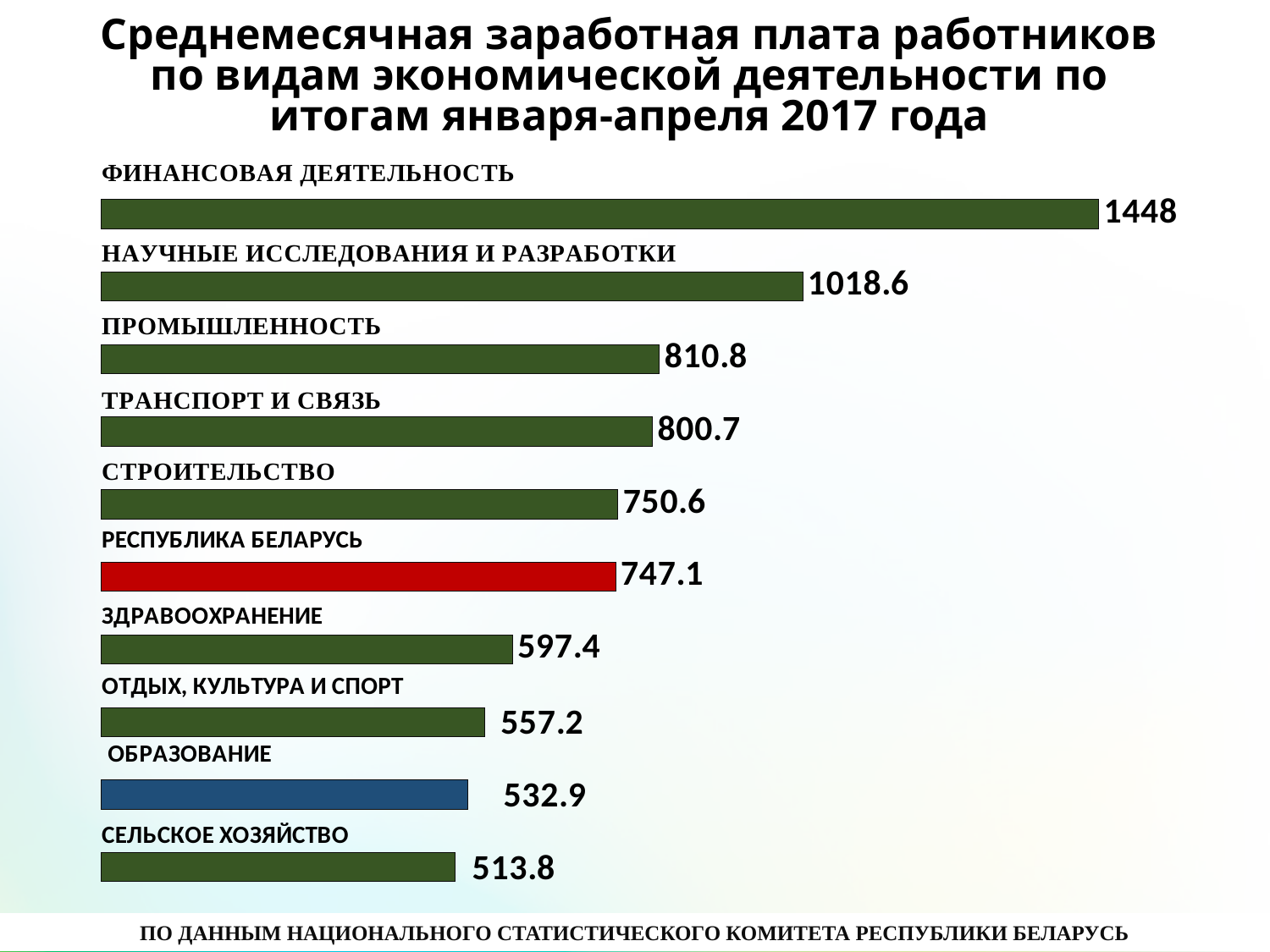
What is the difference between the values for ФИНАНСОВАЯ ДЕЯТЕЛЬНОСТЬ and НАУЧНЫЕ ИССЛЕДОВАНИЯ И РАЗРАБОТКИ? 429.4 Which is larger, the value for ПРОМЫШЛЕННОСТЬ or the value for ТРАНСПОРТ И СВЯЗЬ? ПРОМЫШЛЕННОСТЬ Which category's bar is coloured red? РЕСПУБЛИКА БЕЛАРУСЬ Which category has the lowest value? СЕЛЬСКОЕ ХОЗЯЙСТВО Which category has the highest value? ФИНАНСОВАЯ ДЕЯТЕЛЬНОСТЬ Which is larger, the value for ОТДЫХ, КУЛЬТУРА И СПОРТ or the value for ОБРАЗОВАНИЕ? ОТДЫХ, КУЛЬТУРА И СПОРТ What is the value for РЕСПУБЛИКА БЕЛАРУСЬ? 747.1 What is the difference between the values for ЗДРАВООХРАНЕНИЕ and СЕЛЬСКОЕ ХОЗЯЙСТВО? 83.6 How many categories are shown in the chart? 10 What is the value for ОБРАЗОВАНИЕ? 532.9 What kind of chart is shown on the slide? bar chart What is the value for ФИНАНСОВАЯ ДЕЯТЕЛЬНОСТЬ? 1448